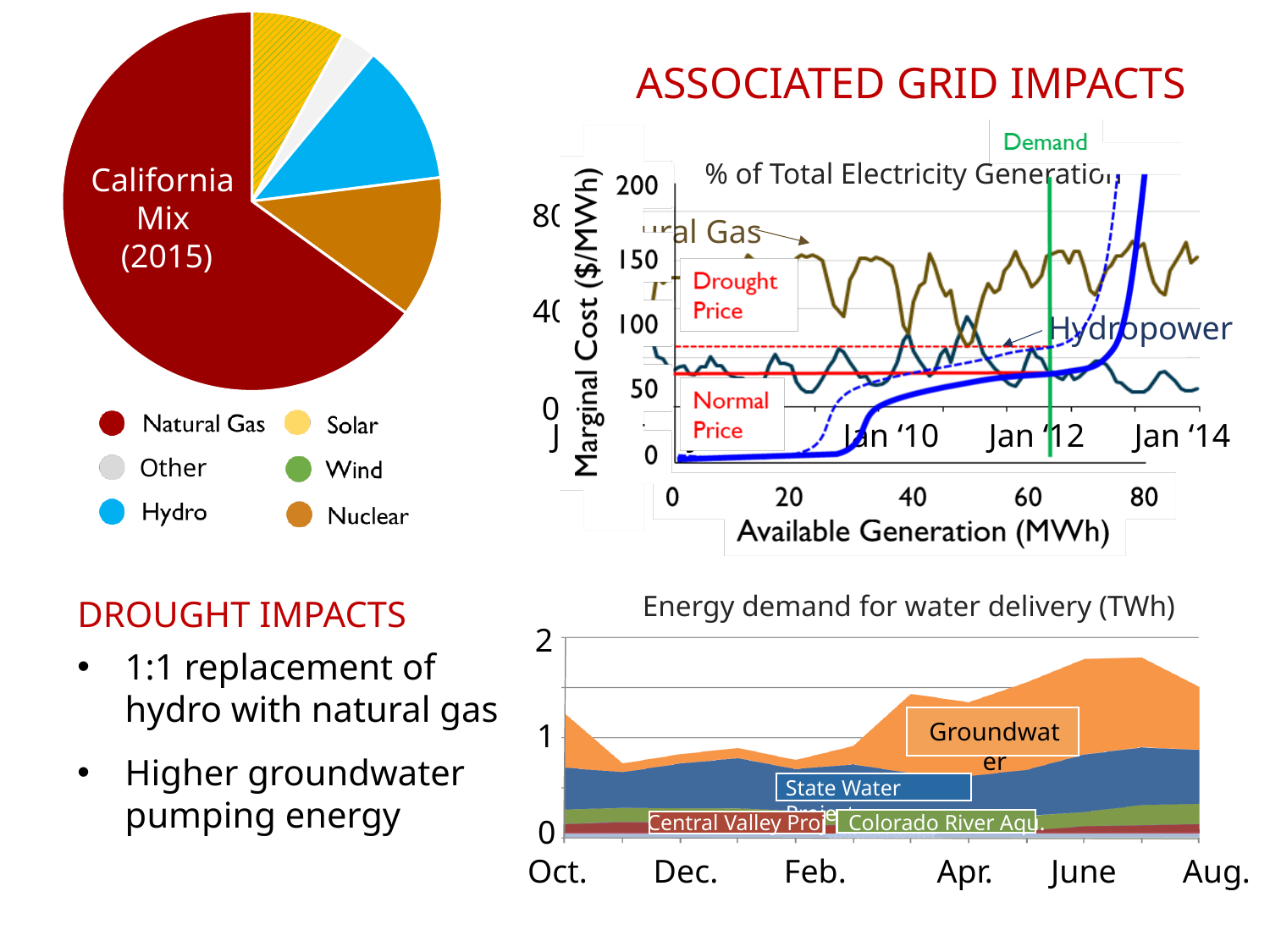
How many sources are listed in the legend of the "California Mix (2015)" pie chart? 6 In the "Energy demand for water delivery (TWh)" chart, is the total demand in Dec. greater or less than 1? less In the "Energy demand for water delivery (TWh)" chart, does the total demand rise or fall from Oct. to Dec.? fall In the "Energy demand for water delivery (TWh)" chart, which labelled component is the largest around June? Groundwater In the "California Mix (2015)" pie chart, which slice is larger, Hydro or Other? Hydro In the "California Mix (2015)" pie chart, which slice is larger, Nuclear or Solar? Nuclear In the "Energy demand for water delivery (TWh)" chart, is the total demand in June greater or less than 1? greater In the "California Mix (2015)" pie chart, which source has the largest slice? Natural Gas How many month labels are shown on the x axis of the "Energy demand for water delivery (TWh)" chart? 6 What is the x-axis label of the marginal cost chart in the "ASSOCIATED GRID IMPACTS" section? Available Generation (MWh) What kind of chart is the "California Mix (2015)" chart at the top left? pie chart What kind of chart is the "Energy demand for water delivery (TWh)" chart at the bottom right? stacked area chart